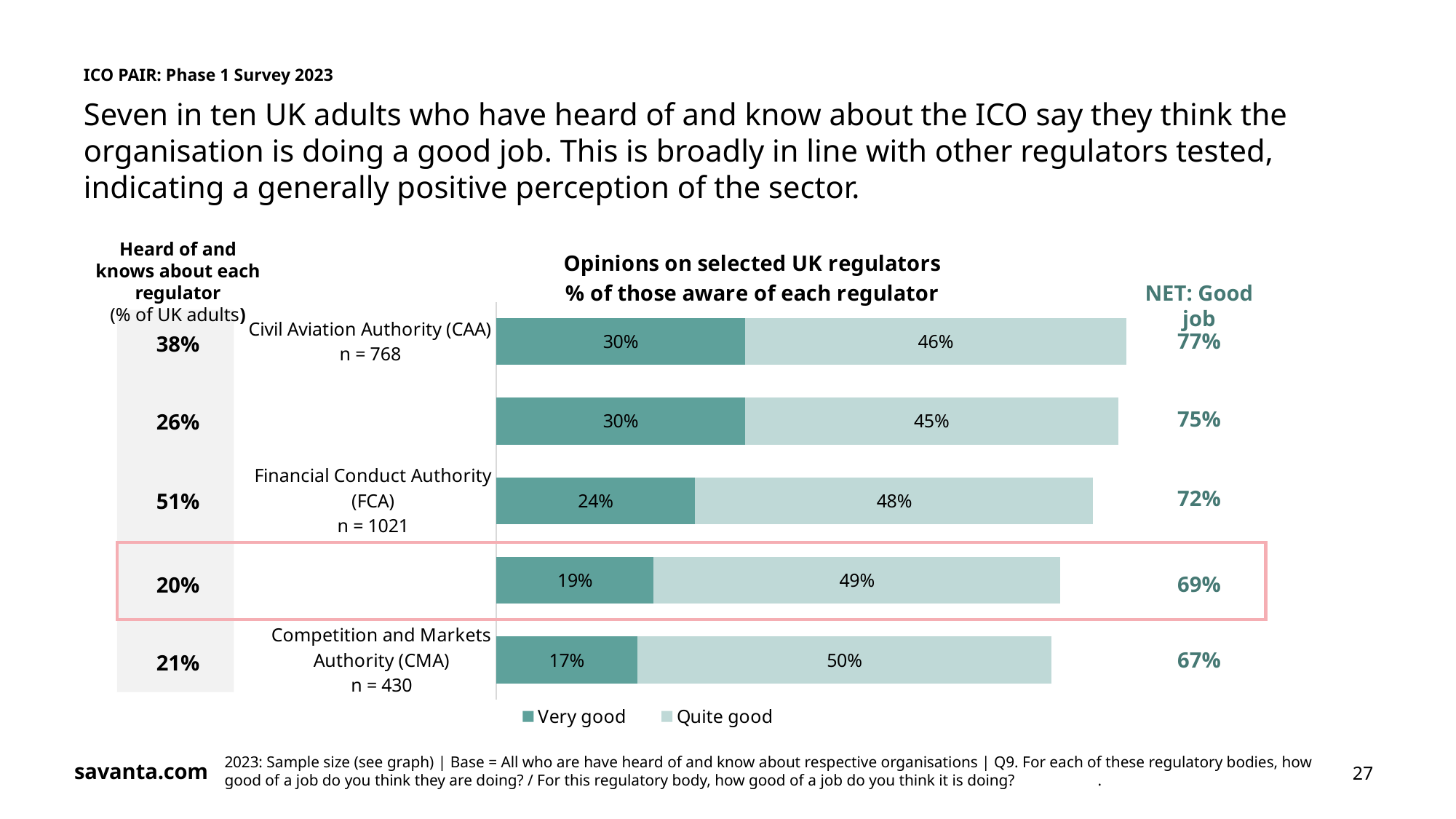
How many percentage points higher is the 'Very good' value for the Civil Aviation Authority (CAA) than for the Financial Conduct Authority (FCA)? 6 percentage points What is the NET: Good job figure for the Competition and Markets Authority (CMA)? 67% What is the 'Quite good' value for the Competition and Markets Authority (CMA)? 50% Which regulator has the lowest 'Very good' value? Competition and Markets Authority (CMA) What is the NET: Good job figure for the Financial Conduct Authority (FCA)? 72% What is the 'Quite good' value for the Financial Conduct Authority (FCA)? 48% Which has the larger 'Quite good' value, the Competition and Markets Authority (CMA) or the Civil Aviation Authority (CAA)? Competition and Markets Authority (CMA) Which regulator has the highest NET: Good job figure? Civil Aviation Authority (CAA) How many series does the legend list? 2 How many bars are shown in the chart? 5 What kind of chart is shown on the slide? Stacked bar chart What percentage of those aware of the Civil Aviation Authority (CAA) rate it as 'Very good'? 30%